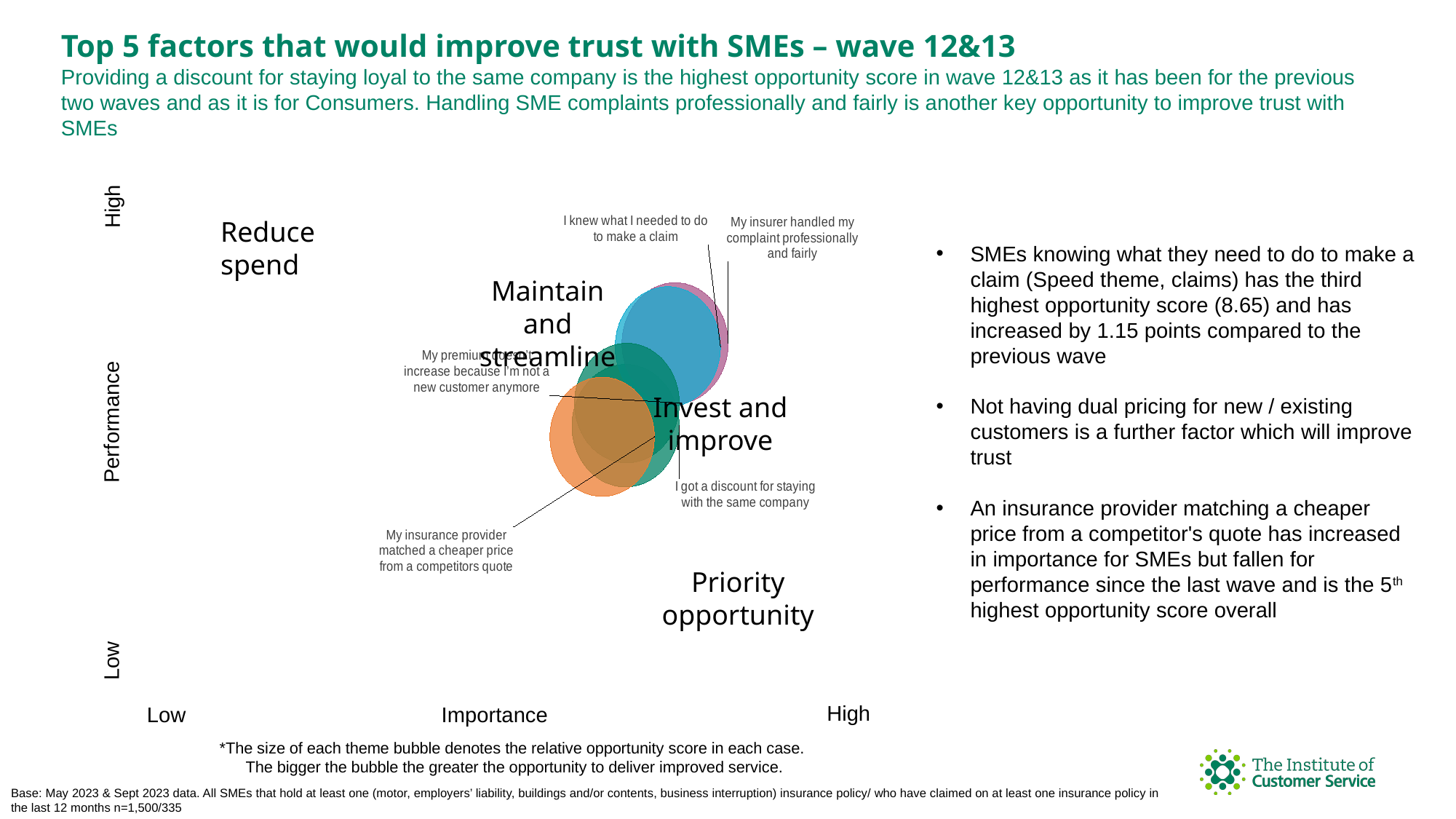
What does the vertical axis of the chart represent? Performance What kind of chart is shown on the slide? Bubble chart How many quadrant labels (such as 'Reduce spend') are shown on the chart? 4 What does the horizontal axis of the chart represent? Importance How many factor bubbles are plotted on the chart? 5 Which is plotted higher on the performance axis: 'I knew what I needed to do to make a claim' or 'My insurance provider matched a cheaper price from a competitors quote'? I knew what I needed to do to make a claim